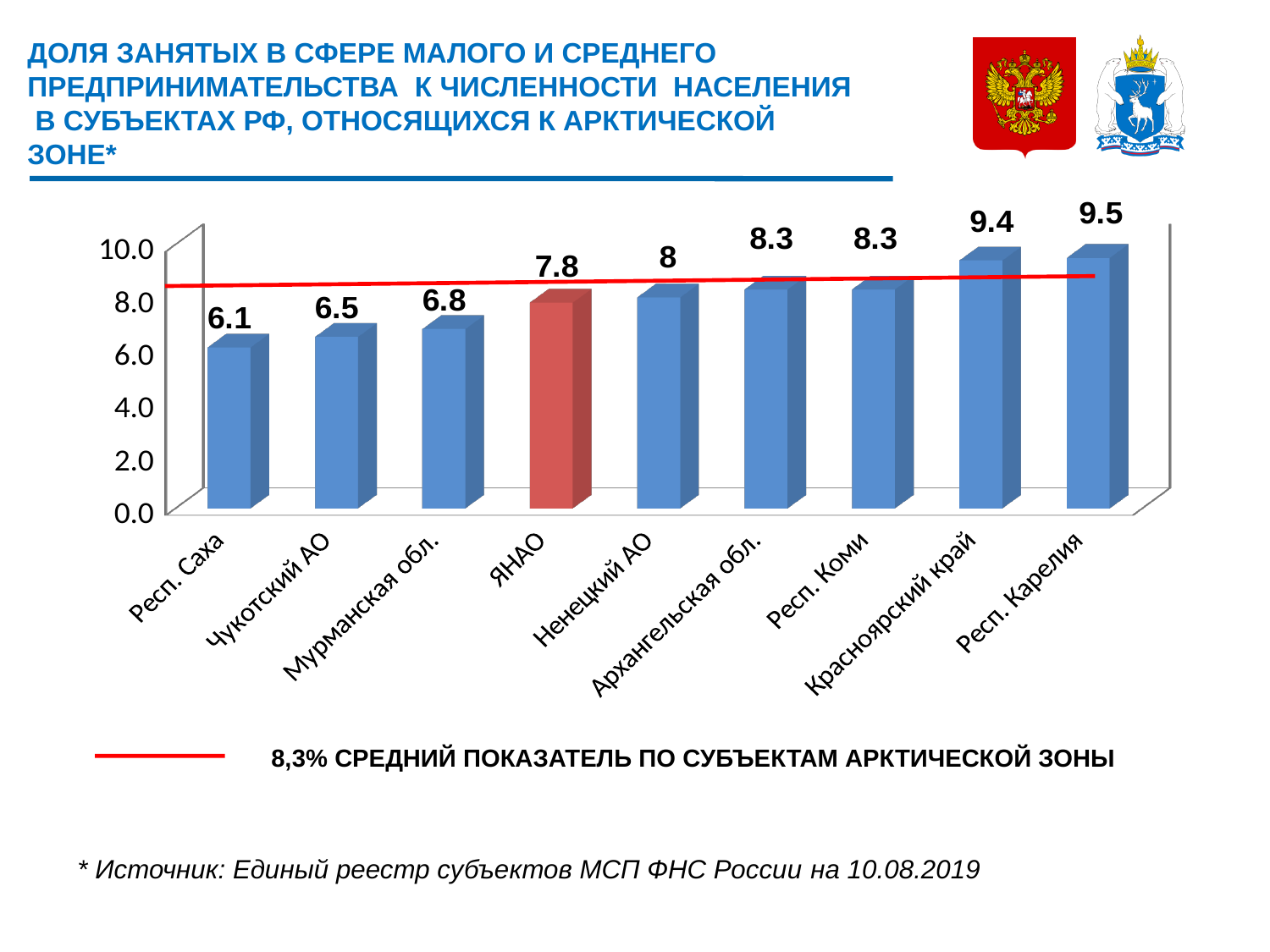
Which region has the lowest value? Респ. Саха What does the red horizontal line on the chart represent? 8,3% средний показатель по субъектам Арктической зоны How many regions are shown on the chart? 9 What is the value for Мурманская обл.? 6.8 Which is larger, the value for Чукотский АО or the value for Ненецкий АО? Ненецкий АО What is the difference between the values for Респ. Карелия and Респ. Саха? 3.4 What is the difference between the values for Ненецкий АО and ЯНАО? 0.2 Which region has the highest value? Респ. Карелия Is the value for Респ. Коми greater or less than 8.0? greater What is the value for ЯНАО? 7.8 What is the value for Красноярский край? 9.4 What kind of chart is shown on the slide? bar chart